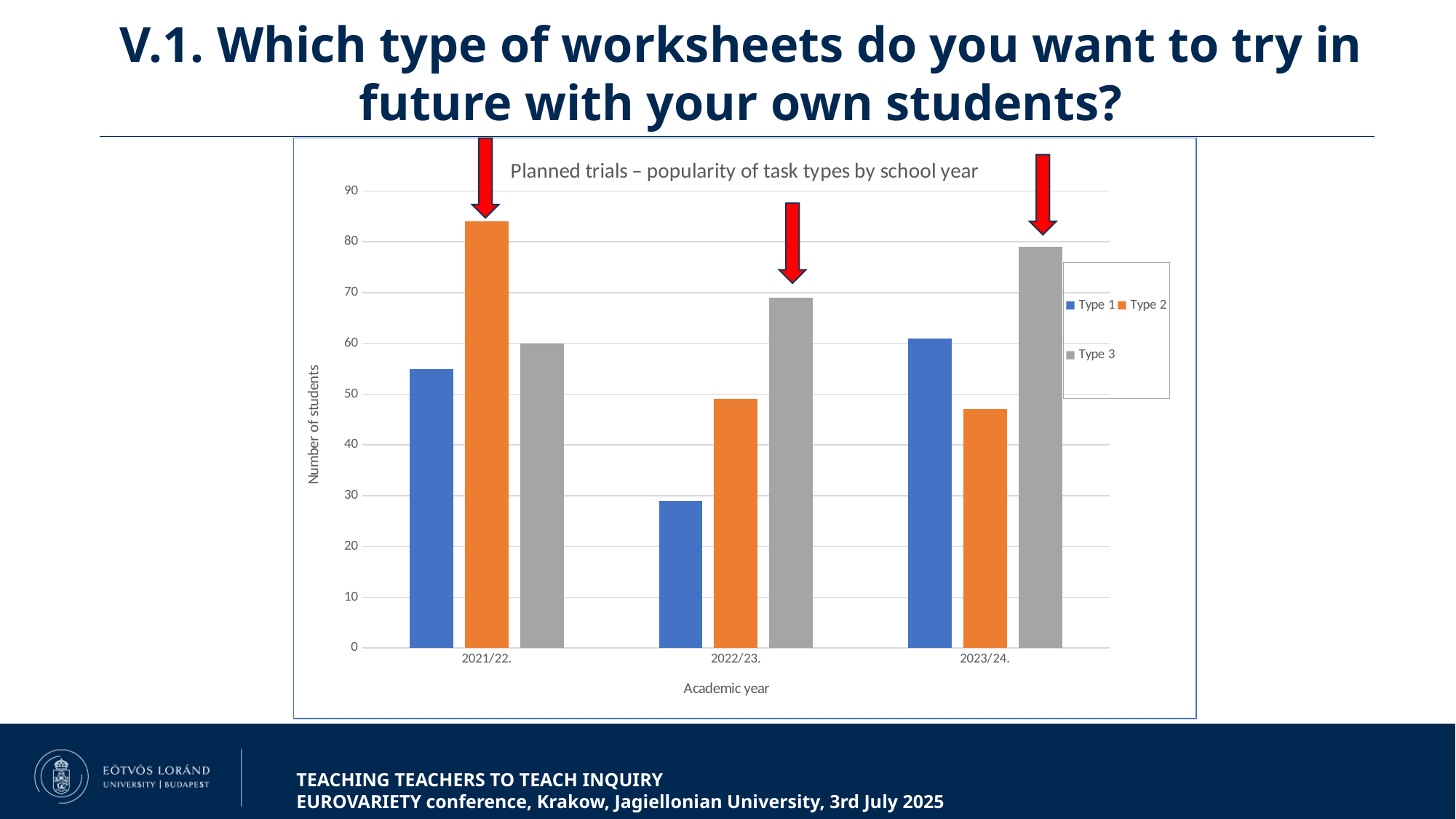
Does the value for Type 3 rise or fall from 2021/22. to 2023/24.? rise How many academic years are shown on the x axis? 3 Which task type has the highest bar in 2021/22.? Type 2 What is the title of the chart? Planned trials – popularity of task types by school year Which task type has the lowest bar in 2023/24.? Type 2 What kind of chart is shown on the slide? bar chart Which task type has the highest bar in 2022/23.? Type 3 Which is larger in 2023/24., Type 1 or Type 2? Type 1 Which task type has the lowest bar in 2022/23.? Type 1 Is the value for Type 2 in 2021/22. greater or less than 80? greater How many series does the legend list? 3